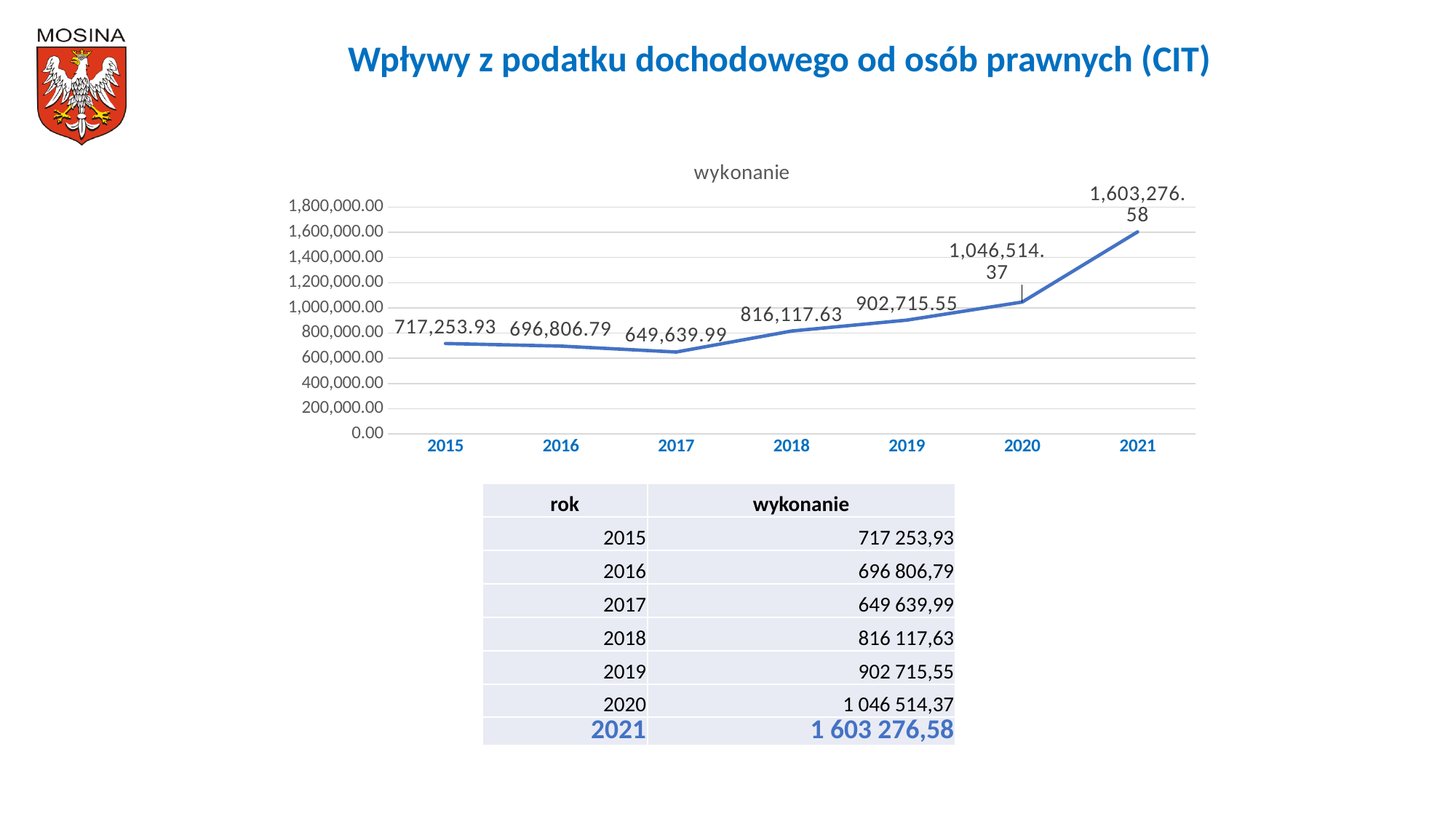
How many years are plotted in the chart? 7 Which year has the lowest value in the chart? 2017 What is the value for 2017 in the chart? 649,639.99 What kind of chart is shown on the slide? line chart What is the value for 2019 in the chart? 902,715.55 What is the value for 2021 in the chart? 1,603,276.58 What is the difference between the values for 2015 and 2016? 20,447.14 Which year has the highest value in the chart? 2021 What is the title of the chart? wykonanie Is the value for 2020 greater or less than 1,000,000.00? greater Which is larger, the value for 2018 or the value for 2016? 2018 What is the difference between the values for 2021 and 2020? 556,762.21